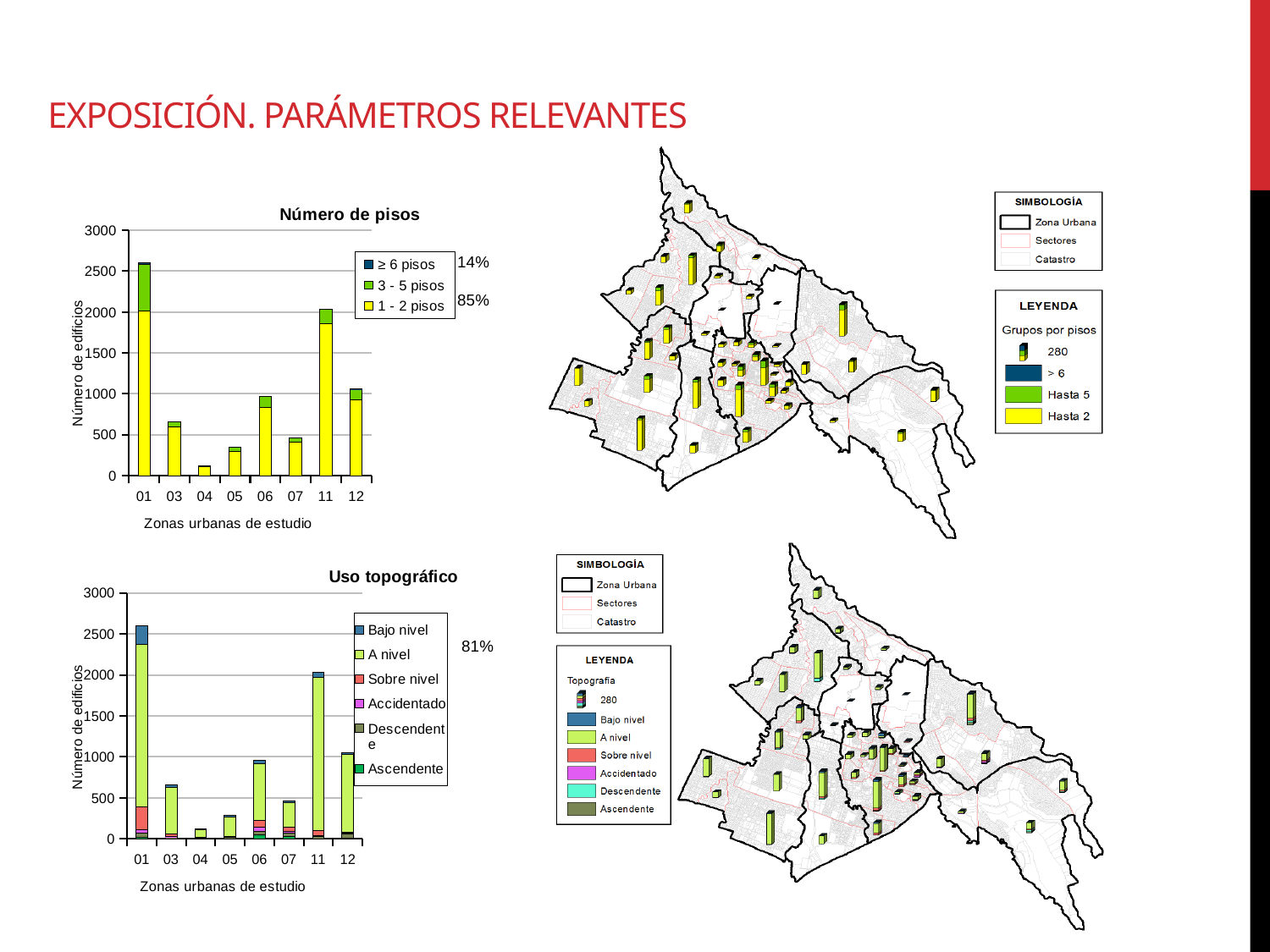
How many series does the legend of the 'Uso topográfico' chart list? 6 In the 'Uso topográfico' chart, which zone has the shortest bar? 04 In the 'Uso topográfico' chart, is the total bar for zone 11 greater or less than 1500? greater In the 'Número de pisos' chart, is the total bar for zone 04 greater or less than 500? less What type of chart is the 'Número de pisos' chart? stacked bar chart What is the label of the y axis on the 'Uso topográfico' chart? Número de edificios In the 'Número de pisos' chart, which bar is taller, zone 01 or zone 11? 01 In the 'Uso topográfico' chart, which bar is taller, zone 03 or zone 05? 03 In the 'Número de pisos' chart, which zone has the tallest bar? 01 How many urban zones are shown on the x axis of the 'Número de pisos' chart? 8 In the 'Número de pisos' chart, is the total bar for zone 01 greater or less than 2500? greater How many series does the legend of the 'Número de pisos' chart list? 3